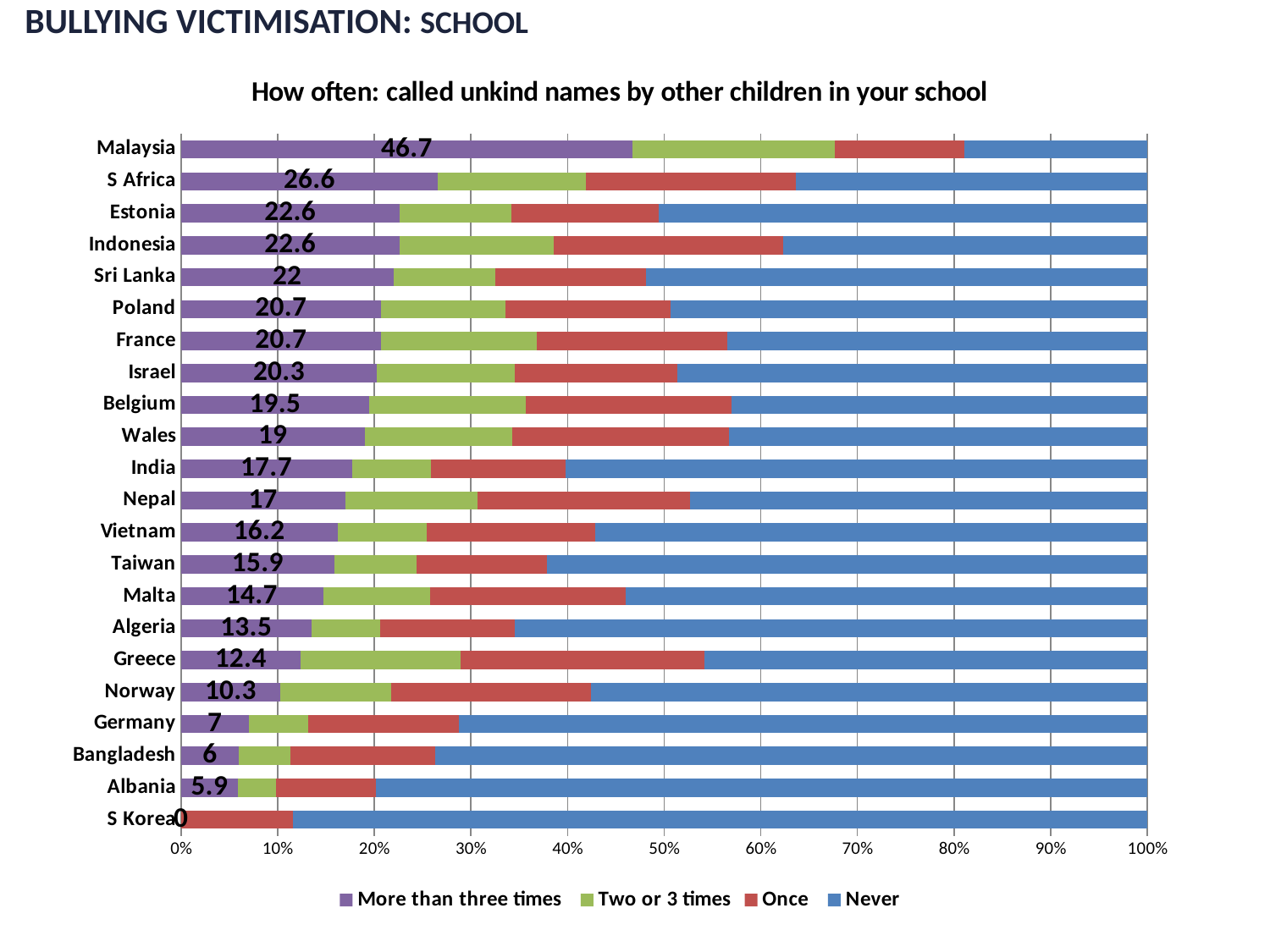
Which country has the highest 'More than three times' value? Malaysia Is the 'Never' share for S Korea greater or less than 80%? greater How many countries are shown on the chart? 22 What kind of chart is shown on the slide? Stacked bar chart What is the 'More than three times' value for Norway? 10.3 Which has a larger 'More than three times' value, Algeria or Greece? Algeria How many series does the legend list? 4 Which country has the lowest 'More than three times' value? S Korea What is the 'More than three times' value for S Korea? 0 What is the value for Malaysia in the 'More than three times' series? 46.7 What is the difference between the 'More than three times' values for Malaysia and S Africa? 20.1 What is the 'More than three times' value for S Africa? 26.6